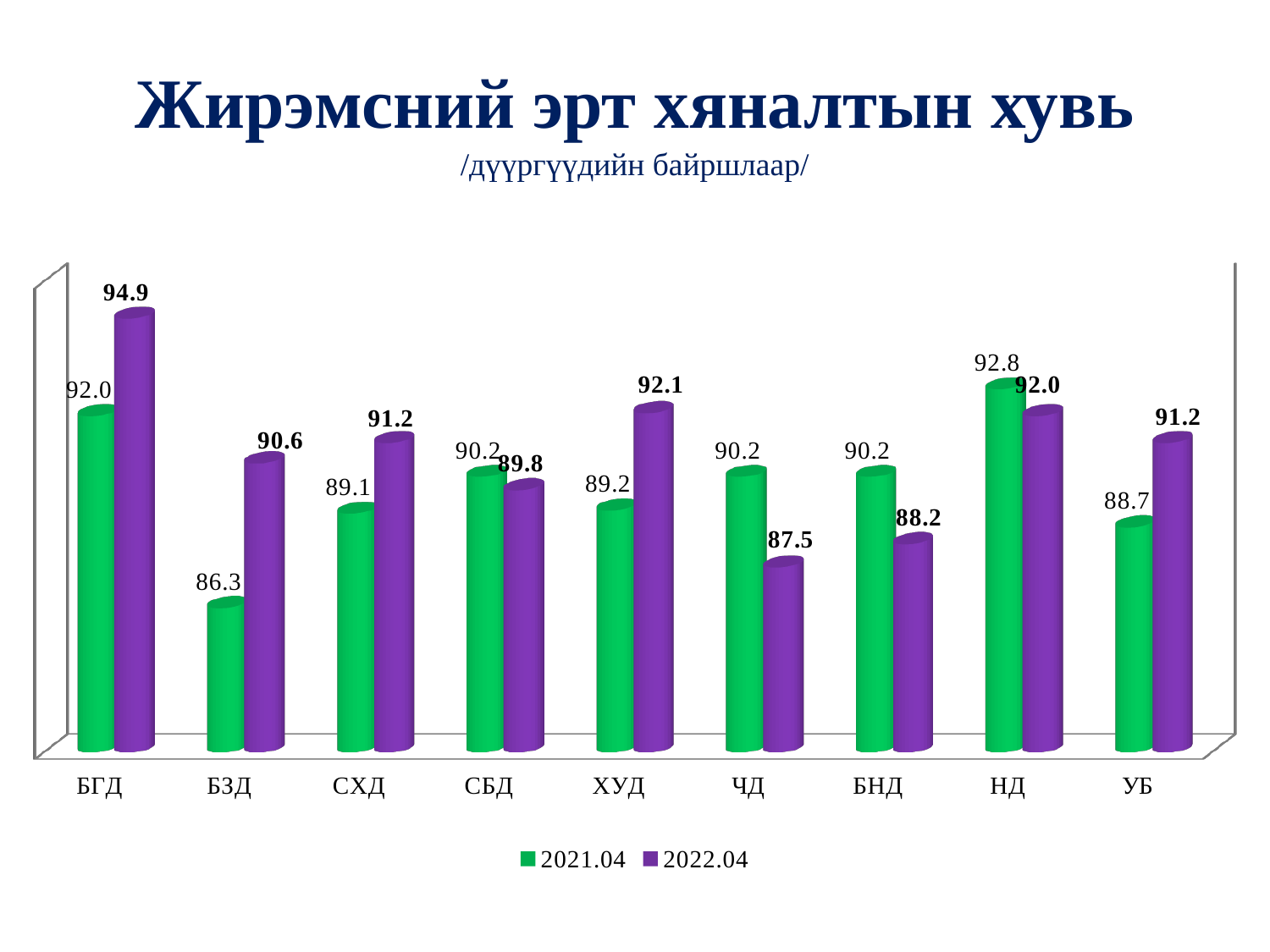
What is the value for БГД in the 2022.04 series? 94.9 What kind of chart is shown on the slide? bar chart What is the value for БЗД in the 2021.04 series? 86.3 Which category has the highest value in the 2022.04 series? БГД What is the difference between the 2021.04 and 2022.04 values for НД? 0.8 How many categories are shown on the x axis? 9 How many series does the legend list? 2 Which is larger for ЧД: the 2021.04 value or the 2022.04 value? 2021.04 What is the difference between the 2022.04 and 2021.04 values for БЗД? 4.3 What is the value for ЧД in the 2022.04 series? 87.5 Which colour represents the 2022.04 series? purple Which category has the lowest value in the 2021.04 series? БЗД